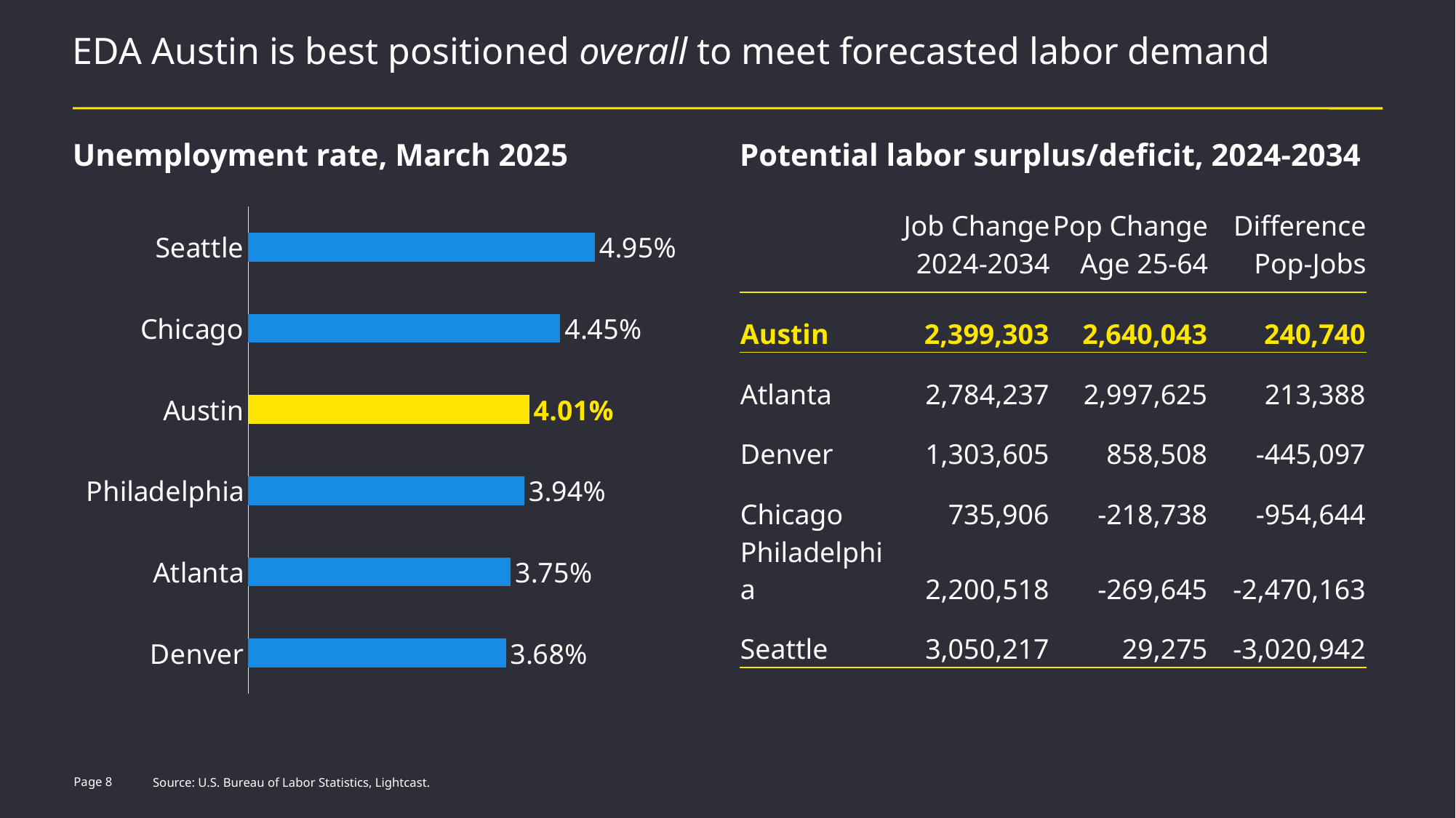
What is the unemployment rate shown for Denver in the bar chart? 3.68% What type of chart is used to show the unemployment rate, March 2025? Bar chart In the bar chart, what is the difference in unemployment rate between Seattle and Denver? 1.27 percentage points In the bar chart, which city has a higher unemployment rate, Chicago or Atlanta? Chicago How many cities are shown in the unemployment rate bar chart? 6 Which city has the lowest unemployment rate in the bar chart? Denver What is the unemployment rate shown for Philadelphia in the bar chart? 3.94% Which city has the highest unemployment rate in the bar chart? Seattle In the unemployment rate bar chart, which city's bar is highlighted in yellow? Austin What is the unemployment rate shown for Seattle in the bar chart? 4.95% What is the unemployment rate shown for Austin in the bar chart? 4.01% In the bar chart, what is the difference in unemployment rate between Chicago and Austin? 0.44 percentage points